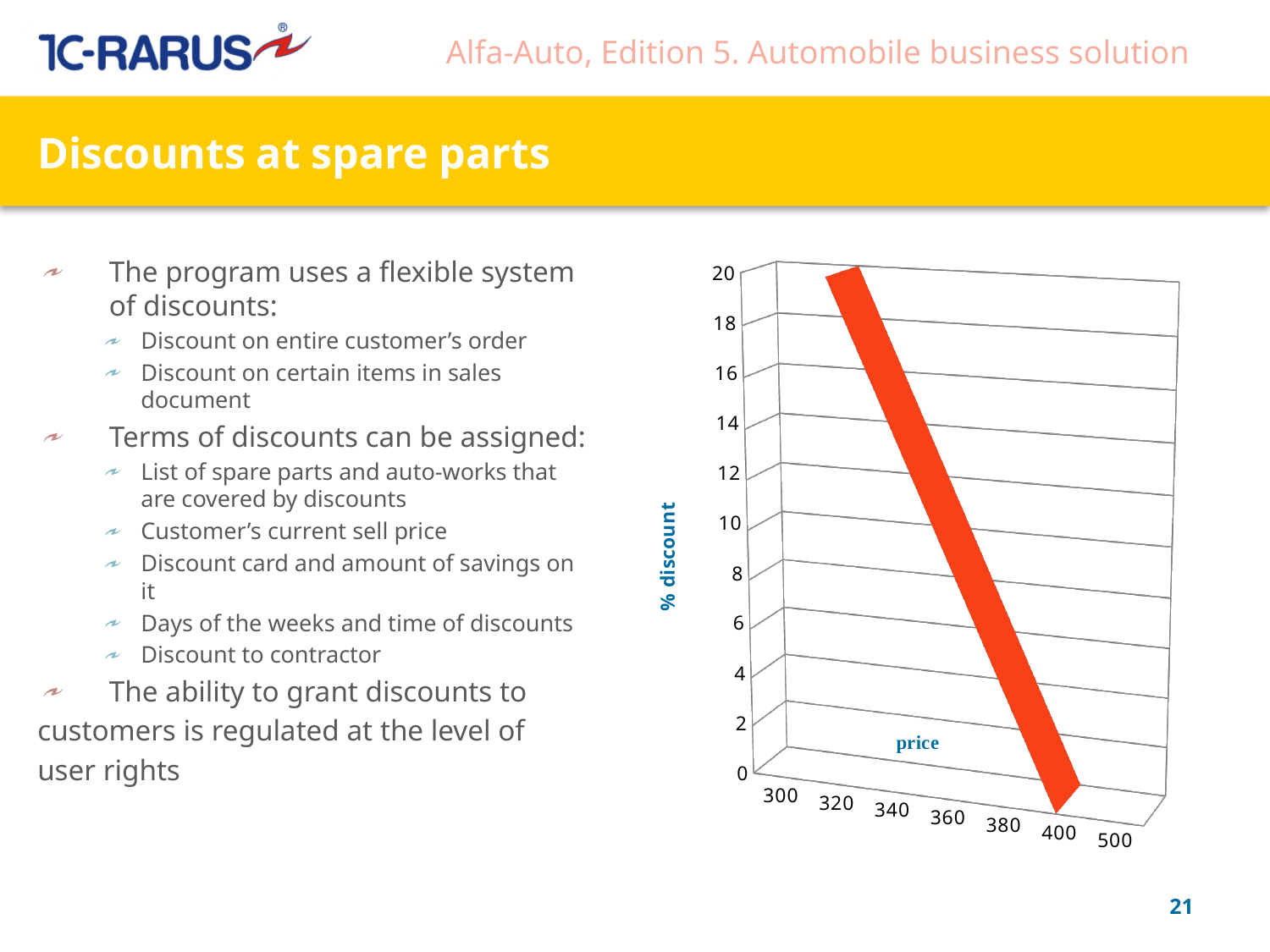
Is the % discount at price 320 greater or less than 10? greater Which price has the higher % discount, 340 or 380? 340 What is the title of the vertical axis of the chart? % discount Does the % discount rise or fall as price increases along the x axis? fall What kind of chart is shown on the slide? line chart Is the % discount at price 340 greater or less than 10? greater Is the % discount at price 400 greater or less than 10? less At which price on the x axis is the % discount lowest? 400 How many price categories are shown on the x axis of the chart? 7 What is the title of the horizontal axis of the chart? price At which price on the x axis is the % discount highest? 320